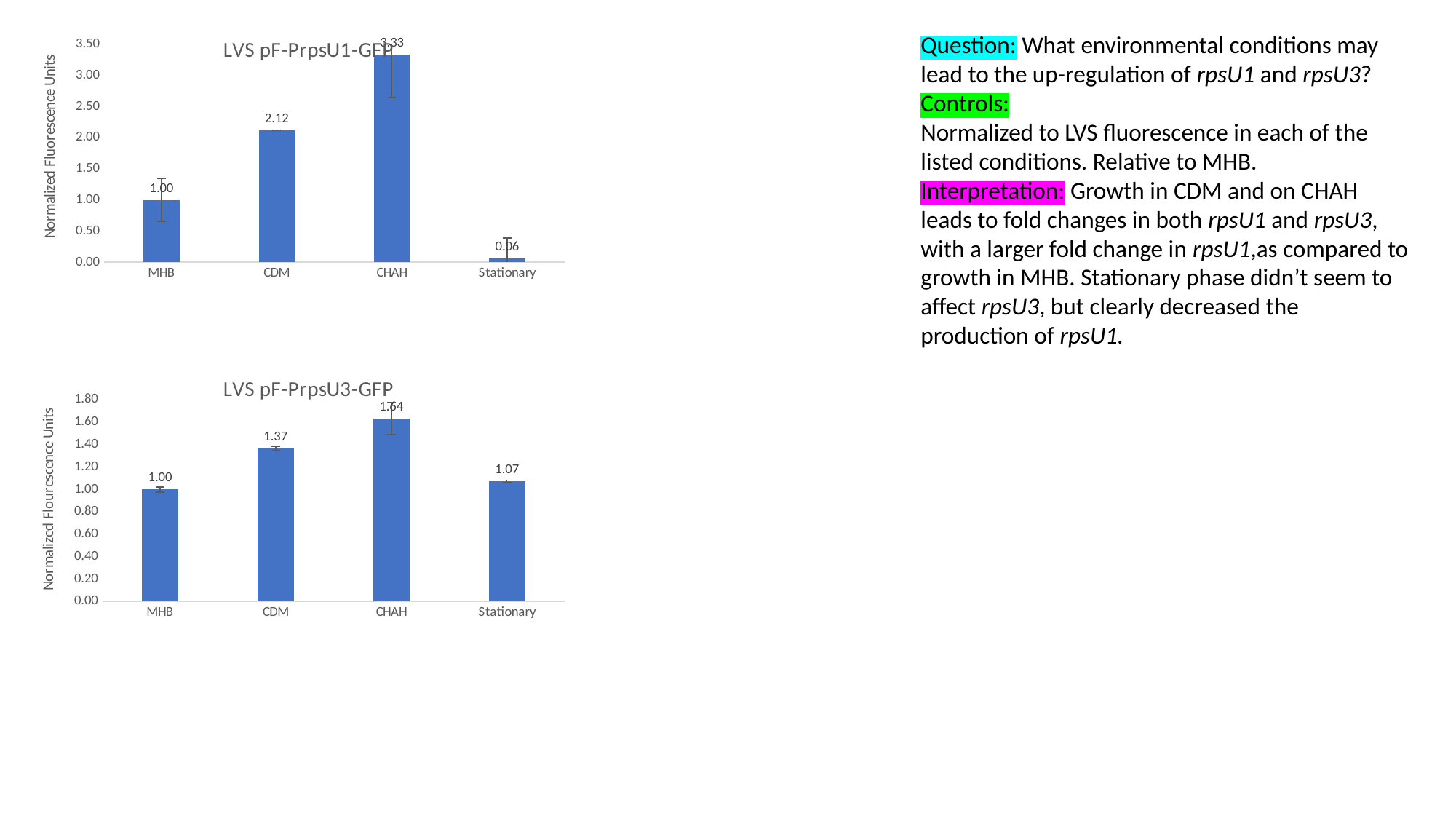
In the LVS pF-PrpsU3-GFP chart, what is the value for CDM? 1.37 In the LVS pF-PrpsU1-GFP chart, which category has the lowest value? Stationary In the LVS pF-PrpsU1-GFP chart, what is the difference between the values for CDM and MHB? 1.12 In the LVS pF-PrpsU3-GFP chart, which is larger, the value for CDM or the value for Stationary? CDM In the LVS pF-PrpsU1-GFP chart, is the value for CHAH greater or less than 3.00? greater In the LVS pF-PrpsU1-GFP chart, which category has the highest value? CHAH In the LVS pF-PrpsU3-GFP chart, which category has the highest value? CHAH How many categories are shown in the LVS pF-PrpsU3-GFP chart? 4 What type of chart is the LVS pF-PrpsU1-GFP chart? bar chart In the LVS pF-PrpsU1-GFP chart, what is the value for CDM? 2.12 In the LVS pF-PrpsU3-GFP chart, what is the value for Stationary? 1.07 In the LVS pF-PrpsU1-GFP chart, what is the value for Stationary? 0.06